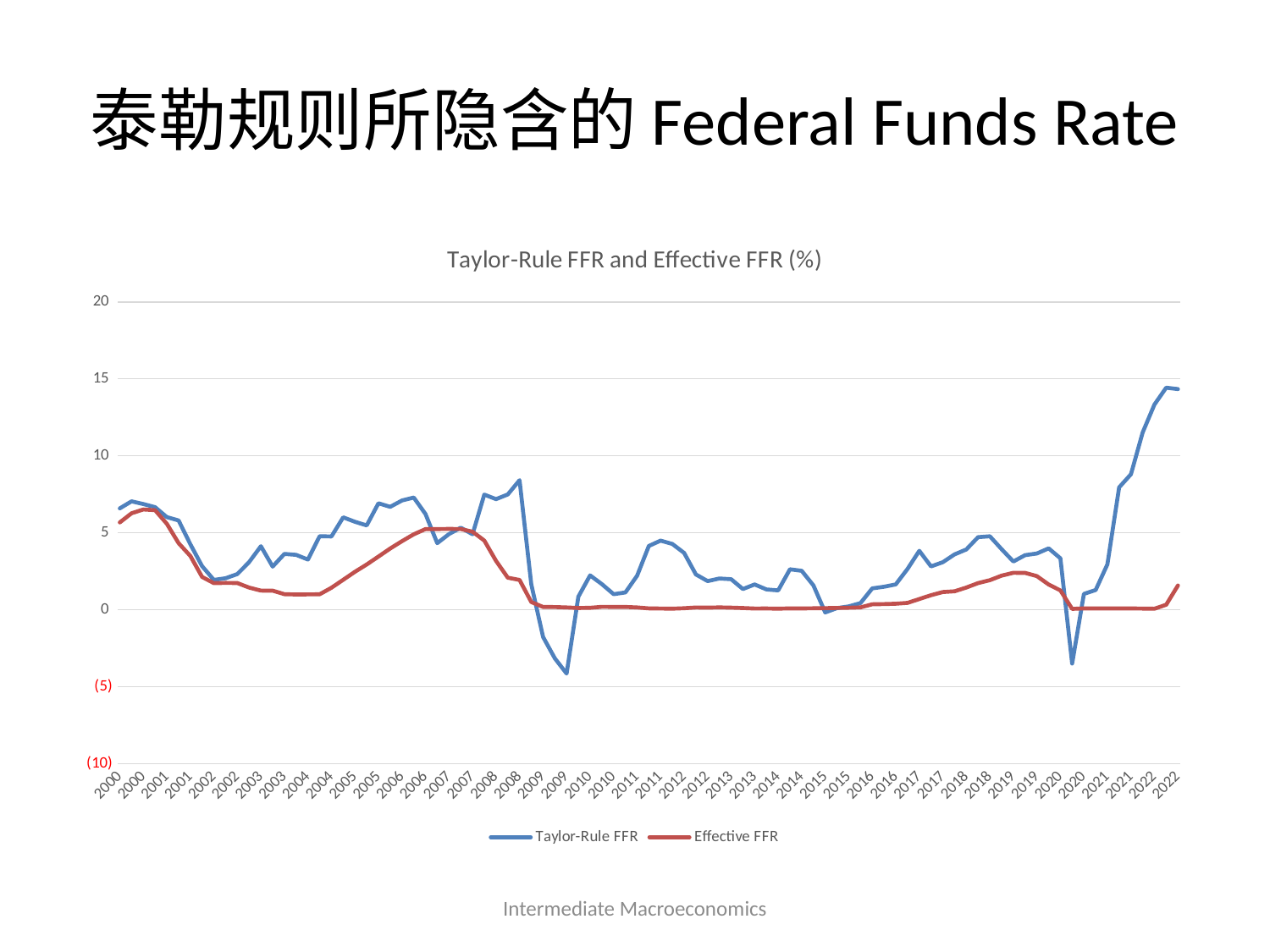
What is the title of the chart? Taylor-Rule FFR and Effective FFR (%) What kind of chart is shown on the slide? line chart How many series does the legend list? 2 Which colour is used for the Effective FFR line? red Which series reaches the lowest value on the chart? Taylor-Rule FFR At the end of 2022, which series is higher, Taylor-Rule FFR or Effective FFR? Taylor-Rule FFR Is the lowest value of the Taylor-Rule FFR in 2009 greater or less than 0? less In 2009, which series is lower, Taylor-Rule FFR or Effective FFR? Taylor-Rule FFR Is the value of the Taylor-Rule FFR at the end of 2022 greater or less than 10? greater Does the Taylor-Rule FFR rise or fall from 2021 to 2022? rise Is the value of the Effective FFR at the end of 2022 greater or less than 5? less Which series reaches the highest value on the chart? Taylor-Rule FFR